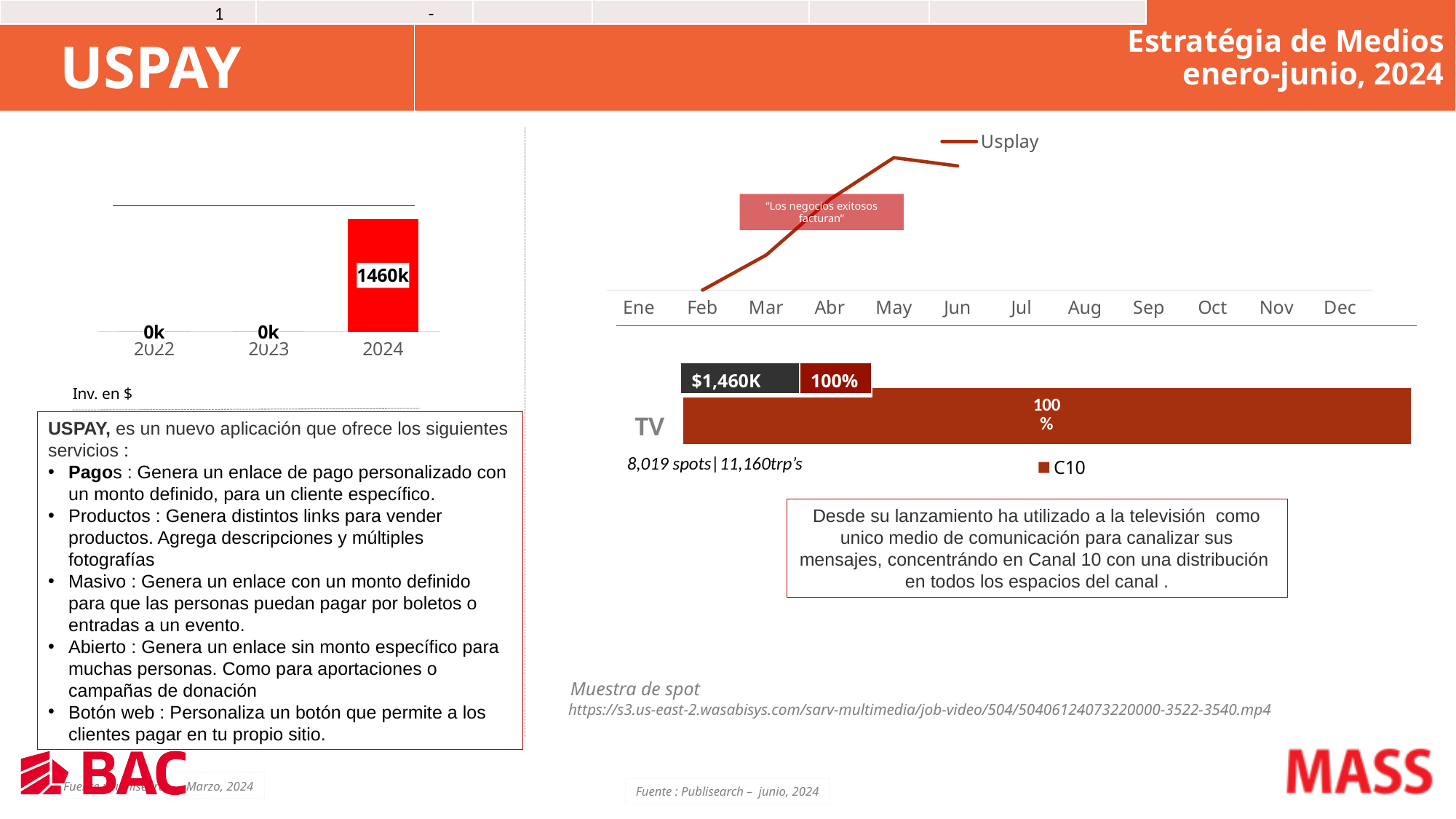
In the TV bar chart on the right, what series does the legend list? C10 In the bar chart on the left, is the value for 2024 larger than the value for 2023? Yes In the line chart at the top right, how many months are listed on the x axis? 12 In the TV bar chart on the right, what share does C10 have? 100% In the bar chart on the left, what is the difference between the 2024 value and the 2023 value? 1460k In the line chart at the top right, what series does the legend list? Usplay What kind of chart is the chart on the left showing investment by year? Bar chart In the bar chart on the left, what is the value for 2024? 1460k In the bar chart on the left, what is the value for 2022? 0k In the line chart at the top right, does the Usplay line rise or fall from Feb to May? Rise In the bar chart on the left, how many years are shown on the x axis? 3 In the bar chart on the left, which year has the highest value? 2024